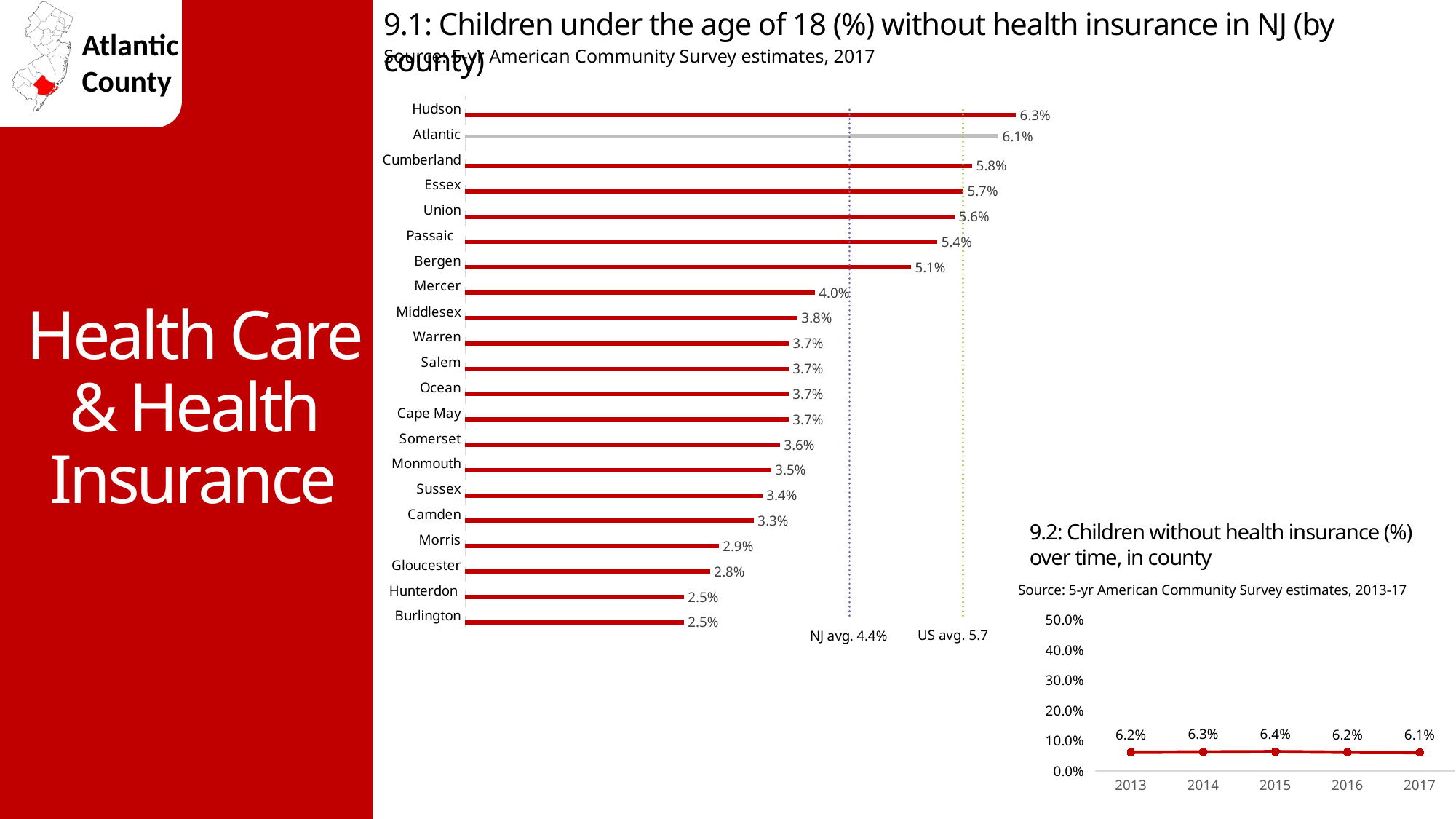
In chart 9.2, is the value for 2013 greater or less than 10.0%? less In chart 9.1, which county has the highest percentage of children without health insurance? Hudson In chart 9.1, which is larger, the value for Passaic or the value for Bergen? Passaic In chart 9.1, what NJ average is marked by the dotted line? 4.4% What kind of chart is chart 9.1? Bar chart In chart 9.1, what is the difference between Hudson and Burlington? 3.8% In chart 9.2, how many years are plotted? 5 In chart 9.2 (children without health insurance over time), what is the value for 2015? 6.4% In chart 9.2, which year has the lowest value? 2017 In chart 9.1 (children under 18 without health insurance by county), what is the value for Atlantic? 6.1% In chart 9.1, how many counties are shown? 21 In chart 9.1, what is the value for Mercer? 4.0%